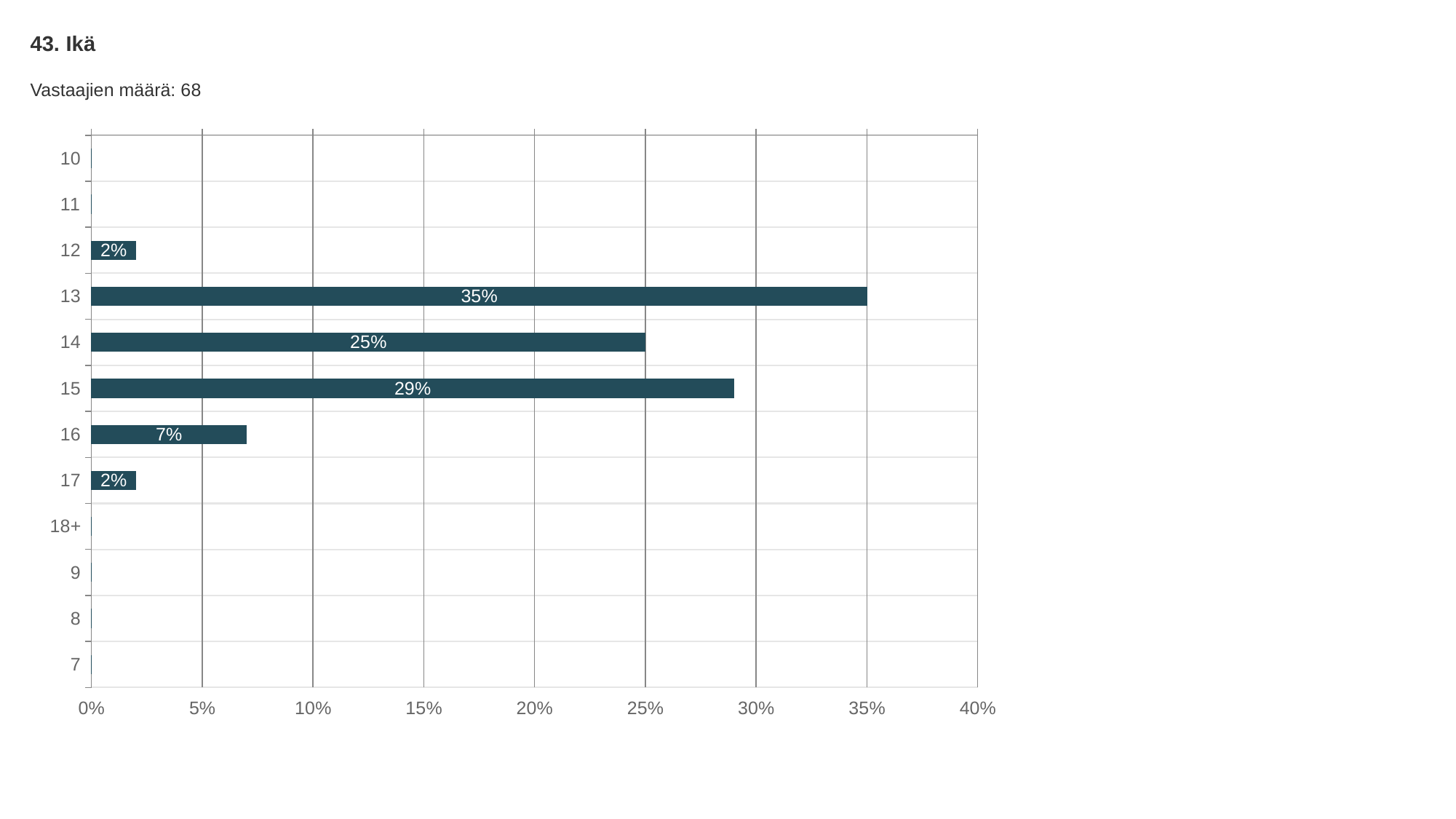
What is the value for age 13? 35% What is the value for age 15? 29% How many age categories are listed on the vertical axis? 12 Which age category has the highest value? 13 Is the value for age 13 greater or less than 30%? greater What is the title of the chart? 43. Ikä Which is larger, the value for age 14 or the value for age 15? 15 How many respondents (Vastaajien määrä) are stated on the slide? 68 What is the difference between the values for age 15 and age 16? 22% What is the value for age 16? 7% What kind of chart is shown on the slide? bar chart What is the difference between the values for age 13 and age 14? 10%